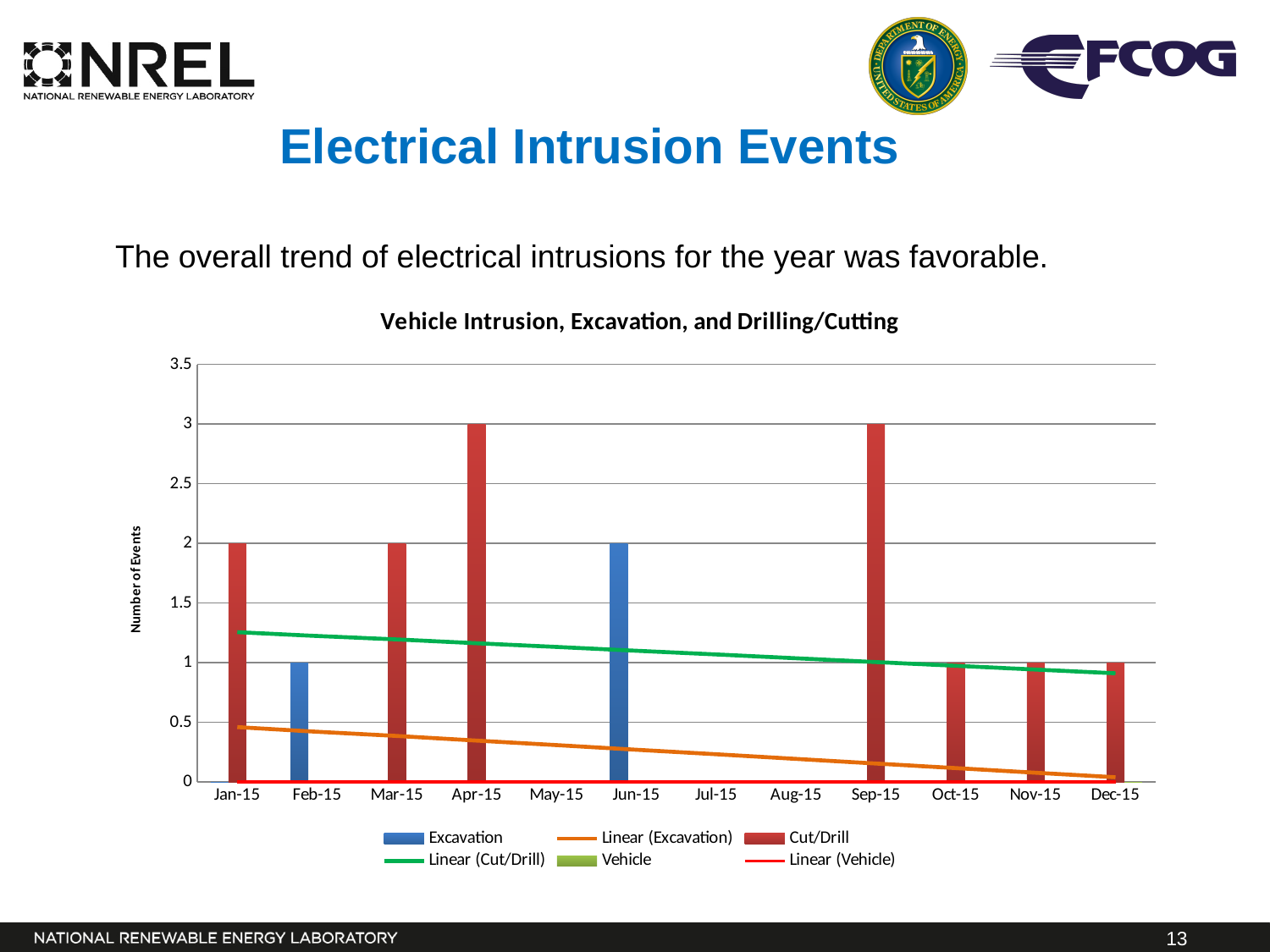
What type of chart is used to show the monthly event counts? bar chart What is the title of the chart? Vehicle Intrusion, Excavation, and Drilling/Cutting What is the Excavation value for Feb-15? 1 How many entries does the legend list? 6 What is the Excavation value for Jun-15? 2 What is the difference between the Cut/Drill value in Sep-15 and the Cut/Drill value in Nov-15? 2 What is the Cut/Drill value for Oct-15? 1 Does the Linear (Cut/Drill) trend line rise or fall from Jan-15 to Dec-15? fall Which is larger, the Cut/Drill value in Jan-15 or the Excavation value in Feb-15? Cut/Drill in Jan-15 How many months are shown on the x axis? 12 Which months have the highest Cut/Drill value? Apr-15 and Sep-15 What is the Cut/Drill value for Apr-15? 3